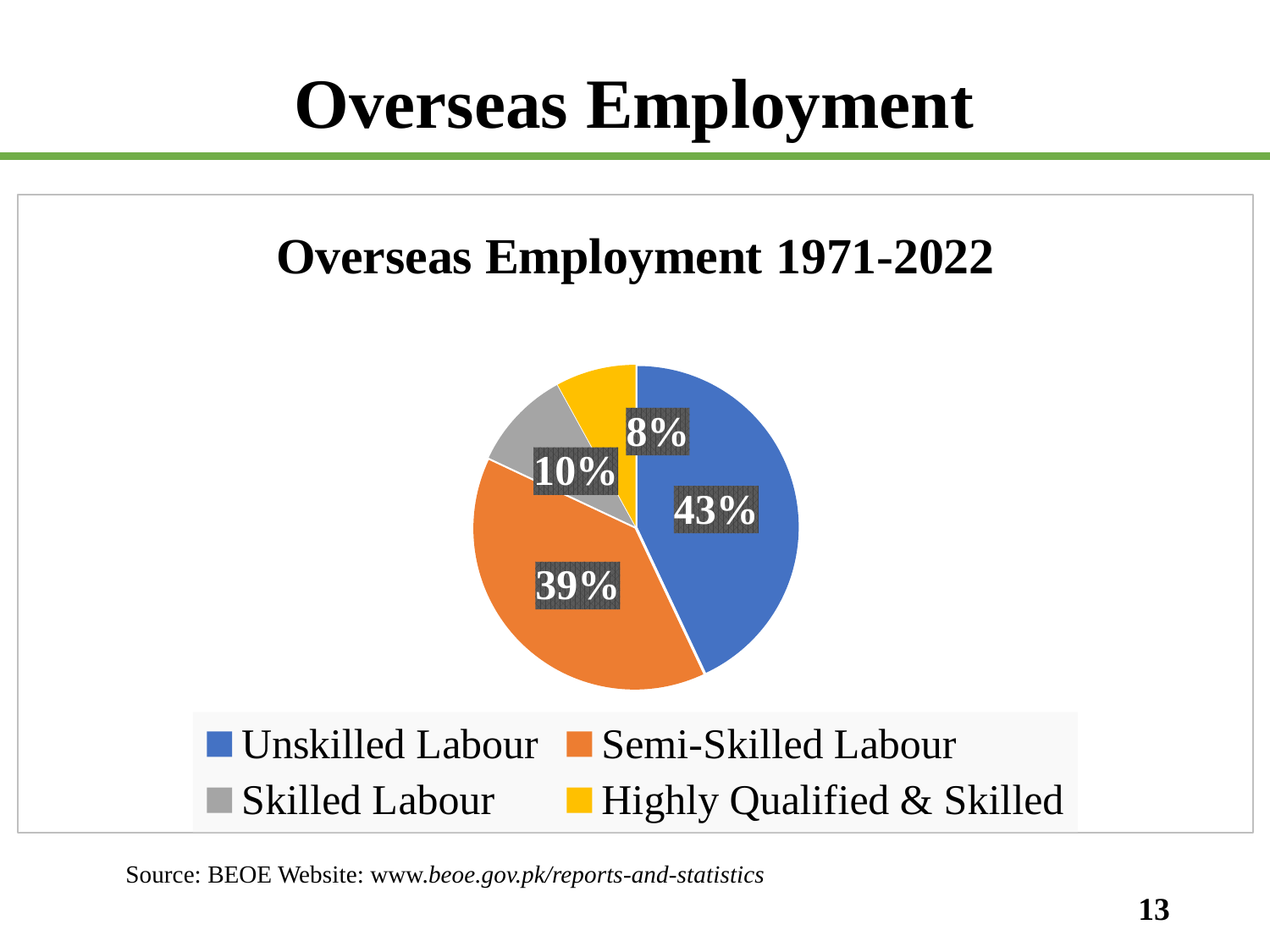
What type of chart is shown on the slide? pie chart Which category has the smallest share of the pie? Highly Qualified & Skilled What share of the pie is Unskilled Labour? 43% What share of the pie is Semi-Skilled Labour? 39% How many categories does the pie chart show? 4 What share of the pie is Highly Qualified & Skilled? 8% What is the difference in percentage points between Unskilled Labour and Semi-Skilled Labour? 4 What is the title of the chart? Overseas Employment 1971-2022 Which is larger, the share for Skilled Labour or the share for Highly Qualified & Skilled? Skilled Labour Which category has the largest share of the pie? Unskilled Labour Which colour represents Semi-Skilled Labour in the legend? orange